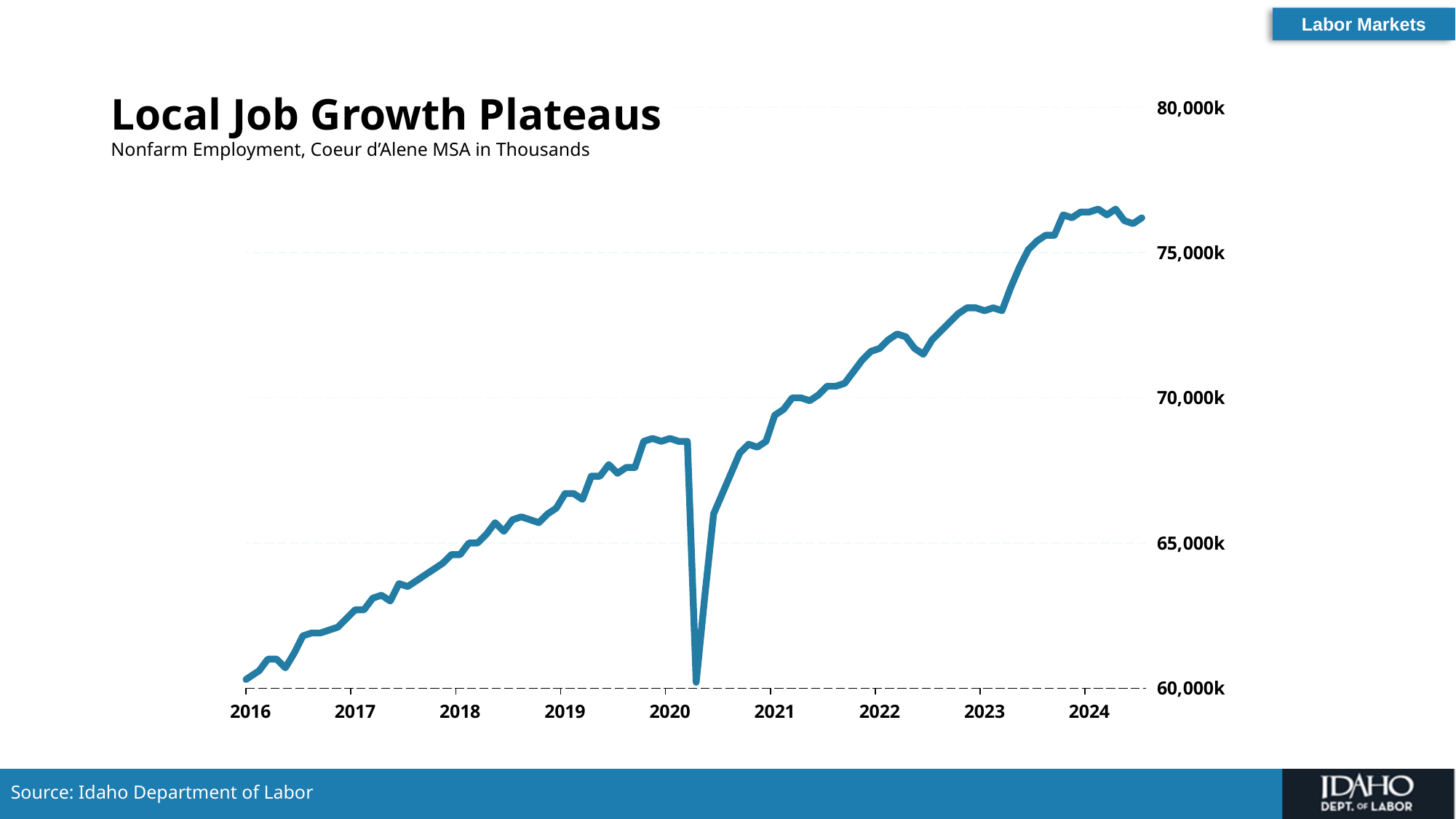
Is the value at the start of 2019 greater or less than 65,000k? greater Is the value at the start of 2022 greater or less than 70,000k? greater What kind of chart is shown on the slide? line chart In which year does the line reach its lowest point? 2020 What is the subtitle of the chart? Nonfarm Employment, Coeur d'Alene MSA in Thousands How many year labels are shown on the x axis? 9 In which year does the line reach its highest point? 2024 Overall, do the values rise or fall from 2016 to 2024? rise Is the value at the start of 2016 greater or less than 65,000k? less What is the title of the chart? Local Job Growth Plateaus